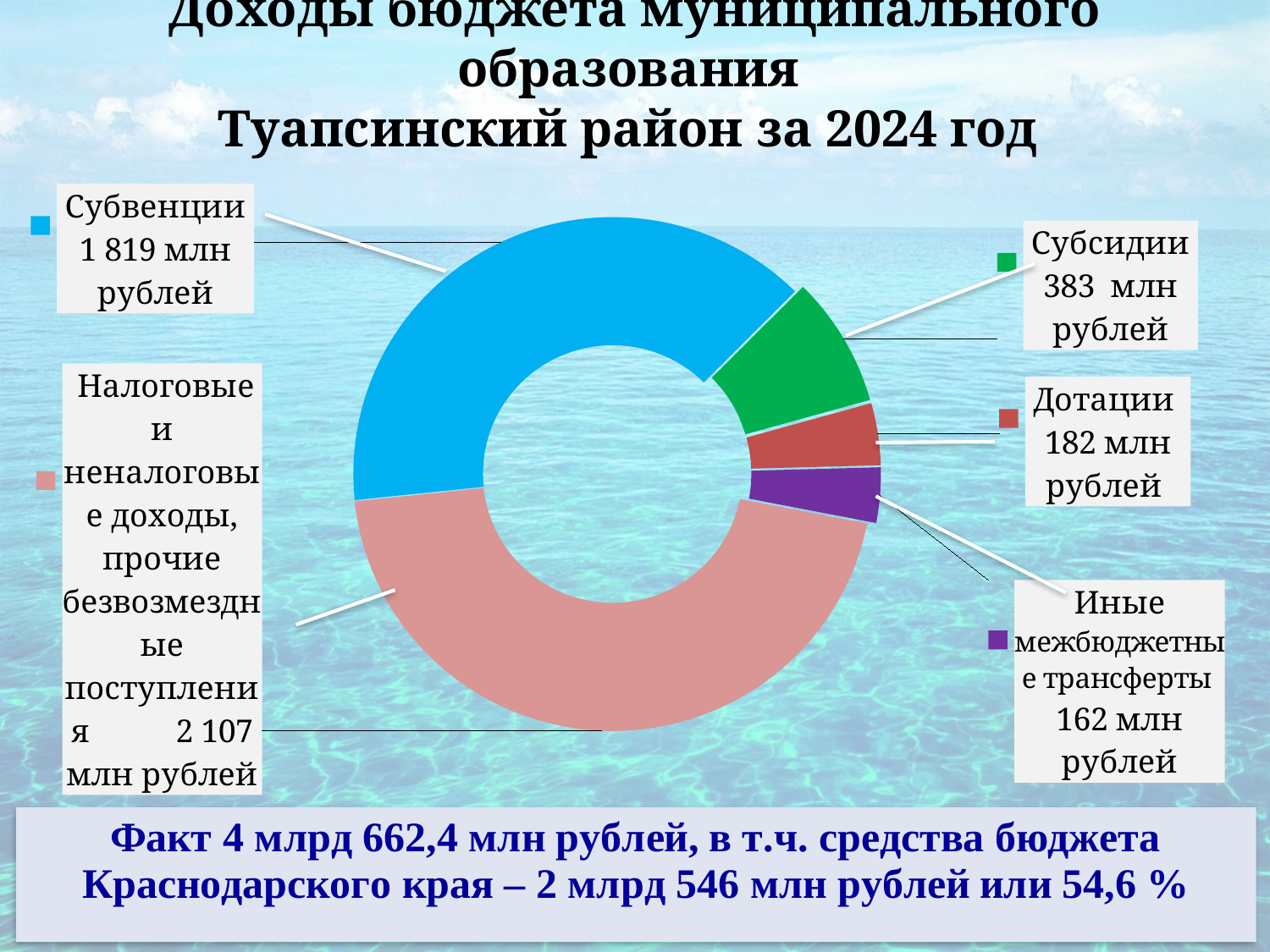
What is the value for Субвенции? 1 819 млн рублей What is the value for Налоговые и неналоговые доходы, прочие безвозмездные поступления? 2 107 млн рублей What is the value for Дотации? 182 млн рублей What kind of chart is shown on the slide? pie chart (donut) What is the difference between Налоговые и неналоговые доходы, прочие безвозмездные поступления and Субвенции? 288 млн рублей How many categories does the chart show? 5 What is the value for Субсидии? 383 млн рублей What is the difference between Субсидии and Дотации? 201 млн рублей Which category has the smallest value? Иные межбюджетные трансферты What is the value for Иные межбюджетные трансферты? 162 млн рублей Which category has the largest value? Налоговые и неналоговые доходы, прочие безвозмездные поступления Which is larger, Субсидии or Дотации? Субсидии